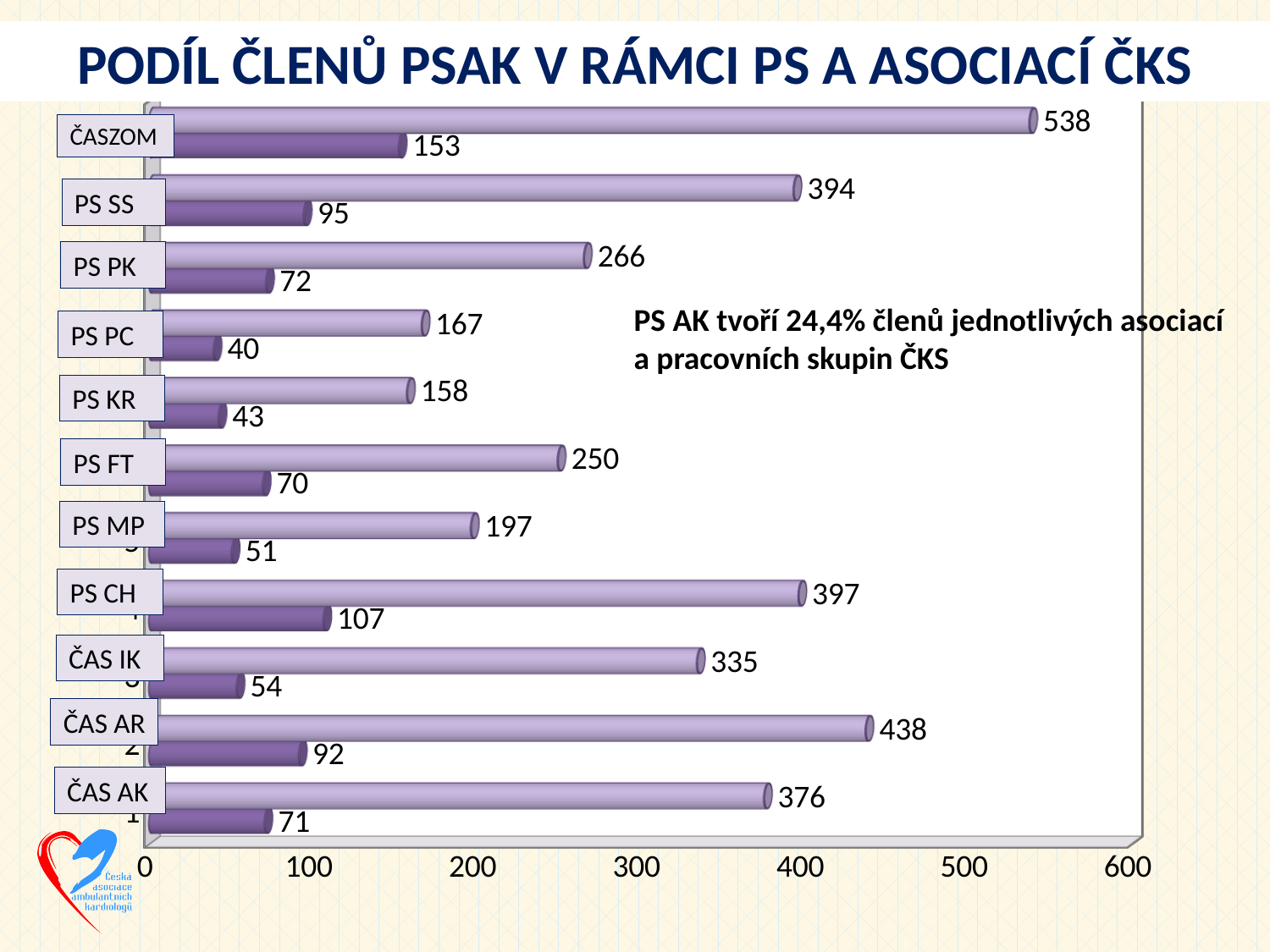
Which category has the highest value among the longer (upper) bars? ČASZOM What is the difference between the two bars for PS SS (394 and 95)? 299 What is the title of the slide containing the chart? PODÍL ČLENŮ PSAK V RÁMCI PS A ASOCIACÍ ČKS What type of chart is shown on the slide? bar chart How many categories are shown on the chart? 11 What is the value of the longer (upper) bar for ČAS AR? 438 What is the value of the shorter (lower) bar for PS CH? 107 What is the value of the longer (upper) bar for ČASZOM? 538 What is the value of the shorter (lower) bar for PS PC? 40 Is the value of the upper bar for ČAS IK greater or less than 300? greater Which is larger: the upper bar for PS FT or the upper bar for PS MP? PS FT Which category has the lowest value among the shorter (lower) bars? PS PC